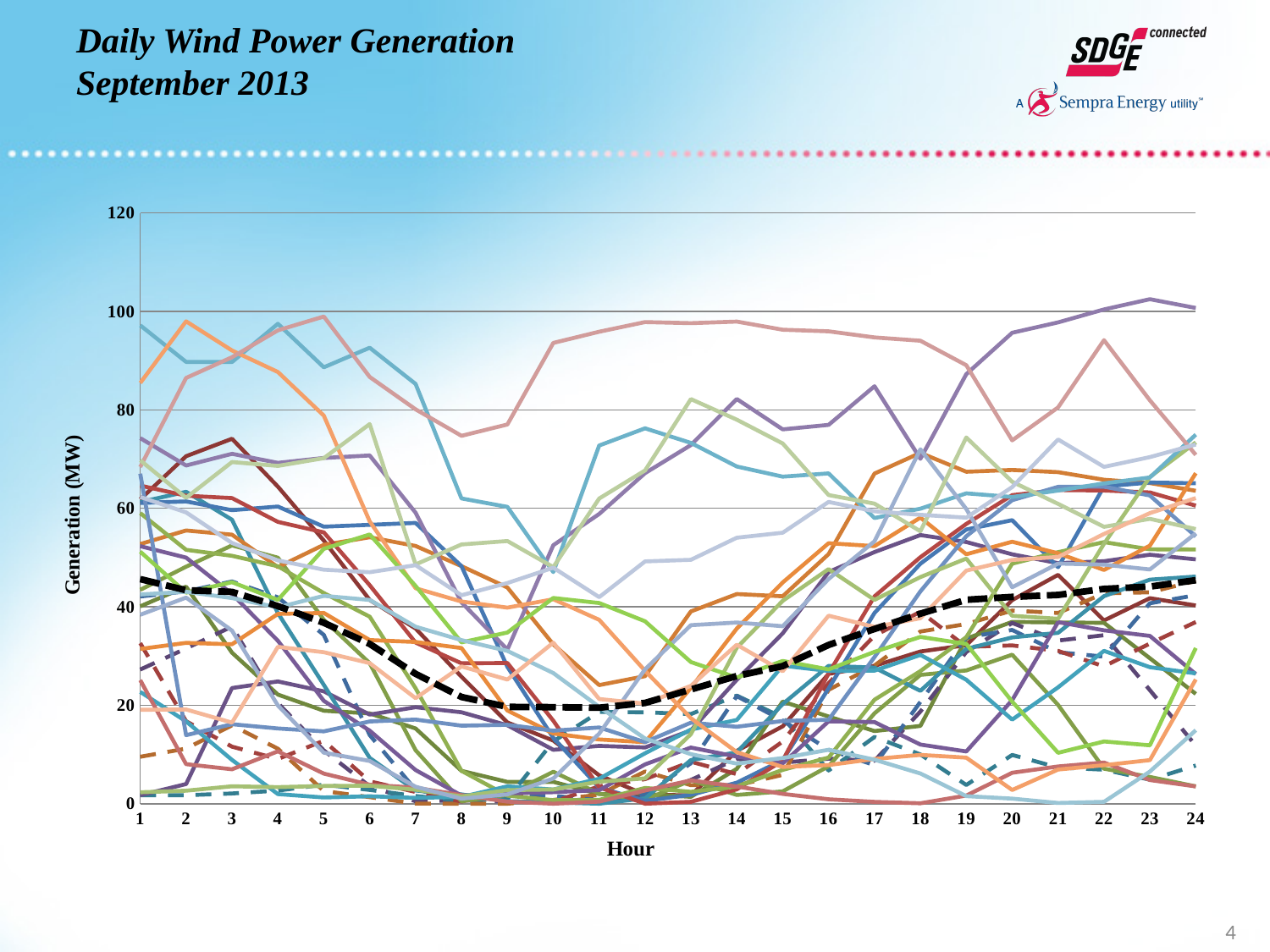
Is the highest value reached by any line on the chart greater or less than 80? greater What is the highest value shown on the y axis? 120 How many hours are shown along the x axis? 24 Is the value of the thick black dashed line at hour 11 greater or less than 40? less Is the value of the thick black dashed line at hour 24 greater or less than 20? greater Does the thick black dashed line rise or fall between hour 1 and hour 11? fall Does the thick black dashed line rise or fall between hour 12 and hour 20? rise What kind of chart is shown on the slide? line chart What is the title of the chart on the slide? Daily Wind Power Generation September 2013 Is the thick black dashed line higher at hour 3 or at hour 11? hour 3 What is the label of the x axis? Hour